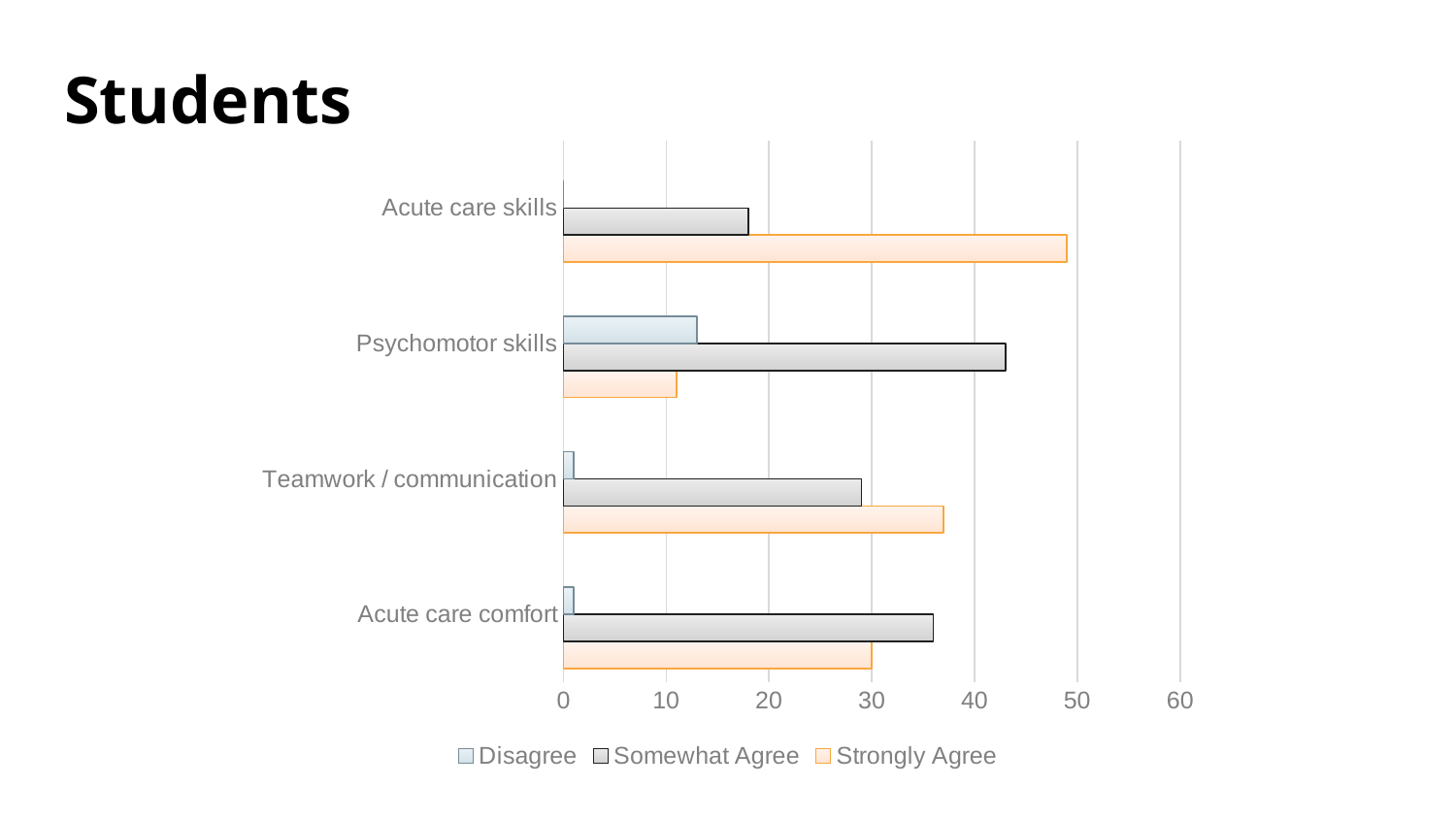
Which category has the highest Disagree value? Psychomotor skills What kind of chart is shown on the slide? bar chart Is the Somewhat Agree value for Acute care skills greater or less than 20? less Is the Strongly Agree value for Acute care skills greater or less than 40? greater For Psychomotor skills, which is larger: Somewhat Agree or Strongly Agree? Somewhat Agree How many categories are shown on the chart? 4 How many series does the legend list? 3 What is the title of the slide containing the chart? Students Which category has the lowest Strongly Agree value? Psychomotor skills Which category has the highest Strongly Agree value? Acute care skills Is the Disagree value for Psychomotor skills greater or less than 10? greater For Teamwork / communication, which is larger: Somewhat Agree or Strongly Agree? Strongly Agree